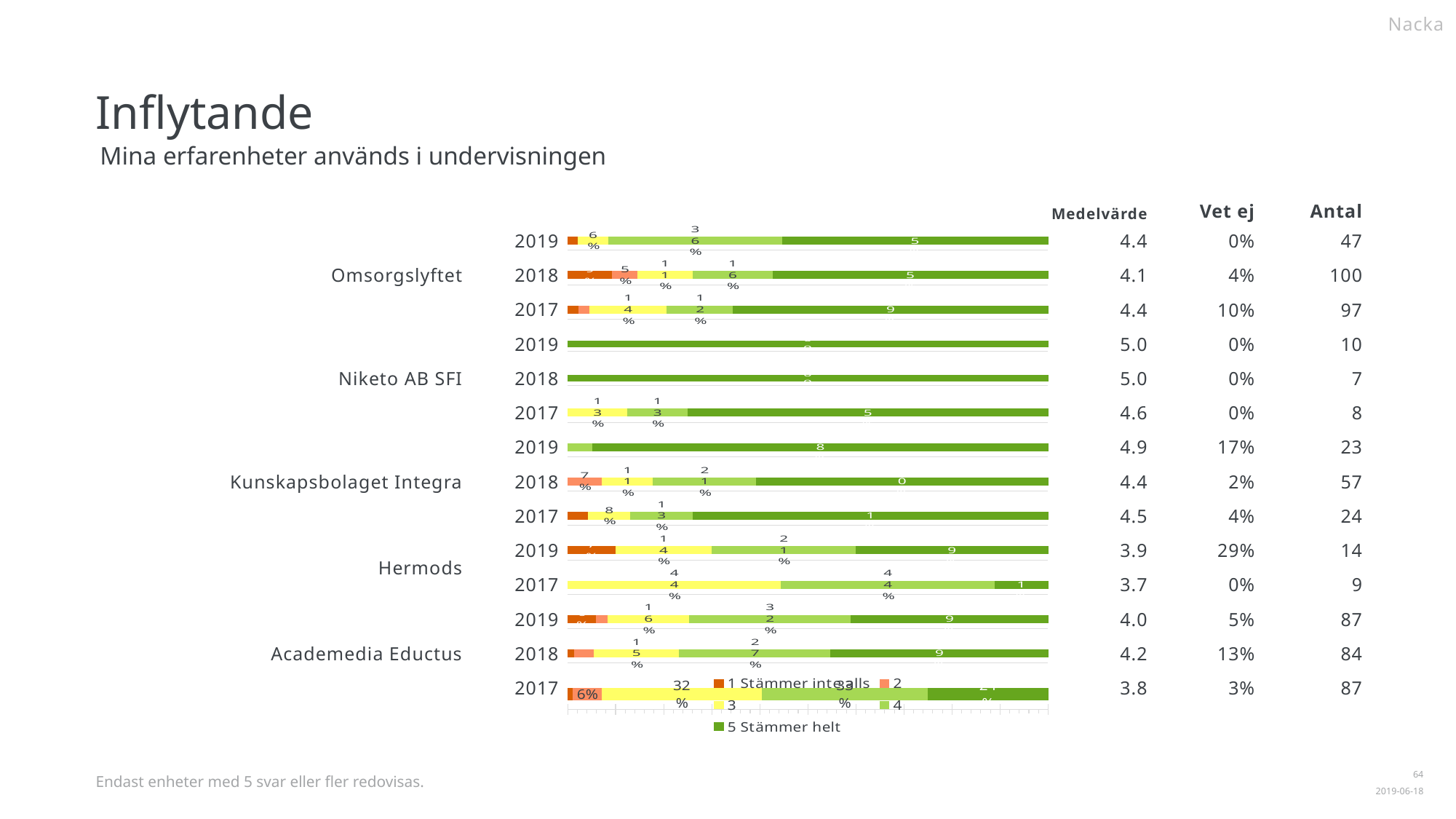
How many bars (organisation-year rows) are plotted in the chart? 14 What is the Antal for Omsorgslyftet in 2018? 100 What kind of chart is shown on the slide? Stacked bar chart What percentage of the Academedia Eductus 2017 bar is the '3' category? 32% What is the Medelvärde for Niketo AB SFI in 2019? 5.0 Which row has the highest Antal? Omsorgslyftet 2018 How many series does the chart legend list? 5 Which row has the lowest Medelvärde? Hermods 2017 What is the difference in Antal between Academedia Eductus 2019 and Academedia Eductus 2018? 3 What is the Vet ej value for Hermods in 2019? 29% Which has the larger Vet ej value: Hermods 2019 or Kunskapsbolaget Integra 2019? Hermods 2019